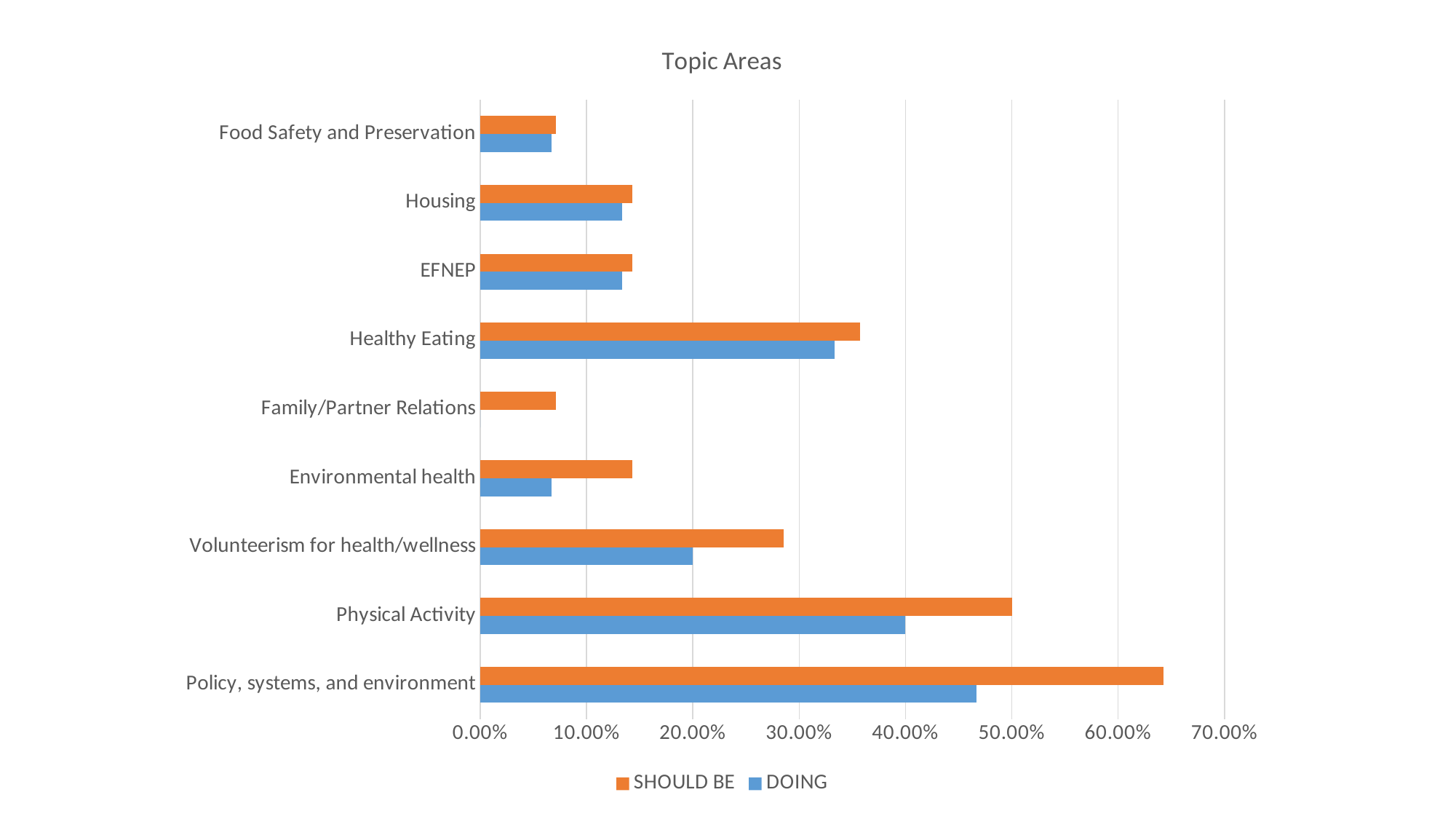
How many topic areas (categories) are shown on the chart? 9 How many series does the legend list? 2 What is the title of the chart? Topic Areas Is the DOING value for Healthy Eating greater or less than 30.00%? greater What is the DOING value for Physical Activity? 40.00% Which topic area has the highest DOING value? Policy, systems, and environment What is the SHOULD BE value for Physical Activity? 50.00% Which topic area has the highest SHOULD BE value? Policy, systems, and environment Is the SHOULD BE value for Policy, systems, and environment greater or less than 60.00%? greater Which topic area has the lowest DOING value? Family/Partner Relations What type of chart is shown on the slide? bar chart For Environmental health, which is larger: the SHOULD BE value or the DOING value? SHOULD BE